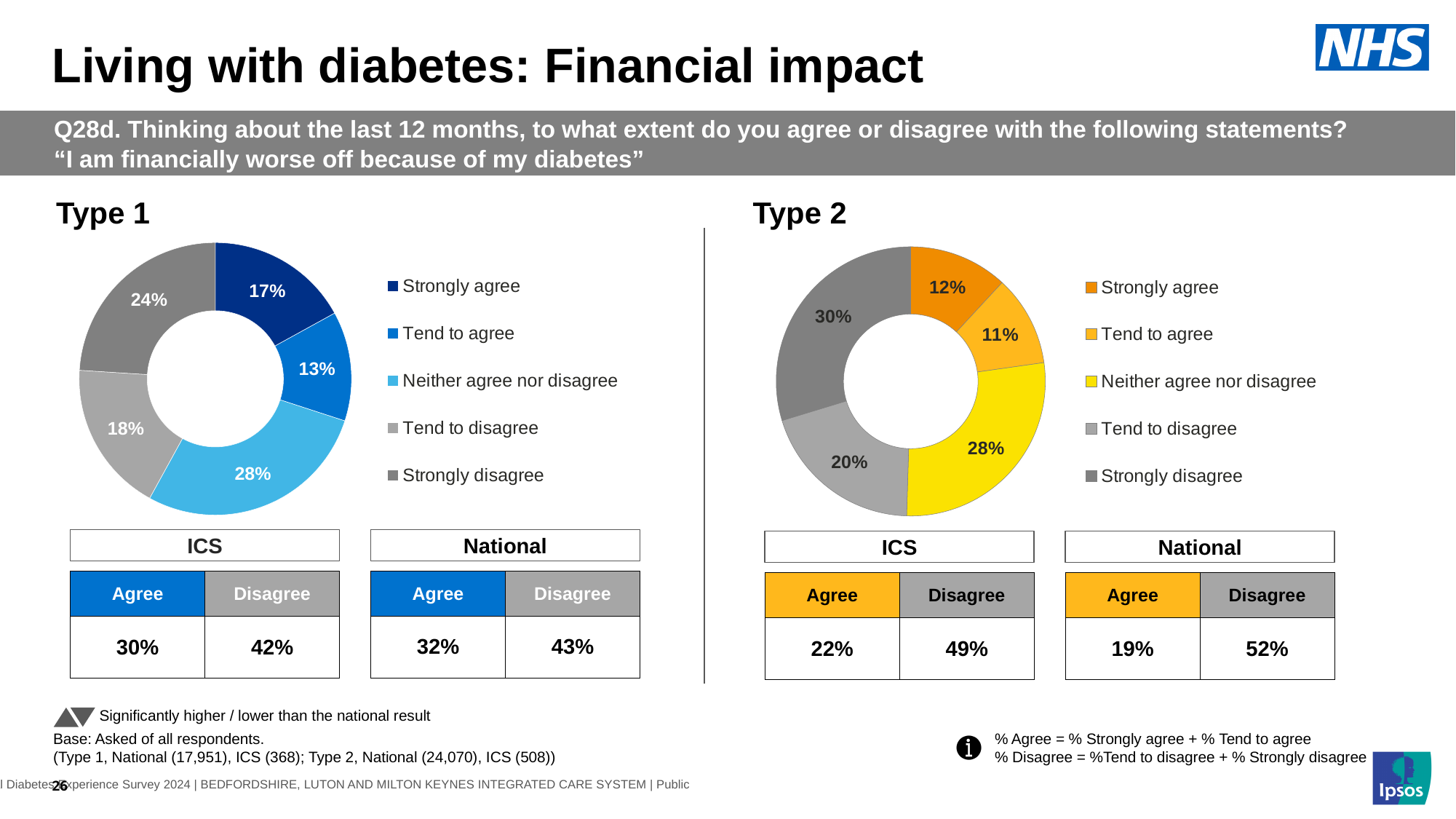
In the Type 1 chart, which response category has the largest share? Neither agree nor disagree In the Type 2 chart, which response category has the smallest share? Tend to agree How many entries does the legend of the Type 2 chart list? 5 In the Type 1 chart, what colour is the Strongly agree slice? Dark blue In the Type 1 chart, what percentage of respondents strongly agree? 17% In the Type 2 chart, which is larger: Strongly agree or Tend to disagree? Tend to disagree In the Type 2 chart, what is the difference between the Strongly disagree and Tend to disagree shares? 10% What kind of chart is the Type 1 chart? Pie chart (doughnut) In the Type 1 chart, what is the difference between the Strongly disagree and Tend to disagree shares? 6% In the Type 2 chart, what share of the pie is Neither agree nor disagree? 28% How many slices does the Type 1 chart have? 5 In the Type 2 chart, what percentage of respondents strongly disagree? 30%